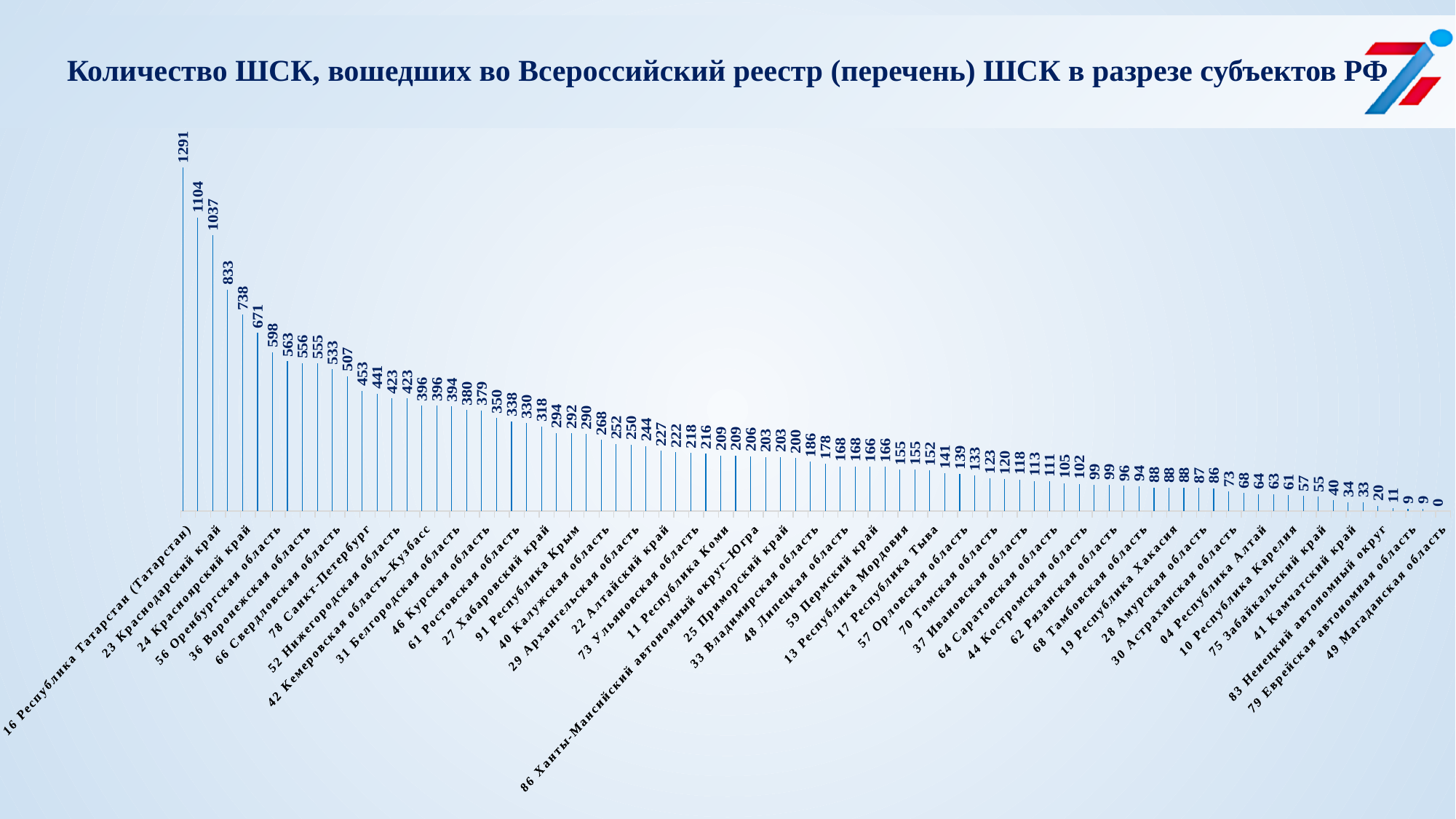
What is the value for 49 Магаданская область? 0 What is the value for 24 Красноярский край? 738 What is the title of the chart? Количество ШСК, вошедших во Всероссийский реестр (перечень) ШСК в разрезе субъектов РФ What is the highest value printed on the chart? 1291 Which region has the lowest value in the chart? 49 Магаданская область Do the values rise or fall from left to right along the x axis? fall What is the value for 23 Краснодарский край? 1037 What is the difference between the values for 16 Республика Татарстан (Татарстан) and 23 Краснодарский край? 254 Which is larger, the value for 23 Краснодарский край or the value for 24 Красноярский край? 23 Краснодарский край Which region has the highest number of ШСК in the chart? 16 Республика Татарстан (Татарстан) What is the value for 16 Республика Татарстан (Татарстан)? 1291 What kind of chart is shown on the slide? bar chart